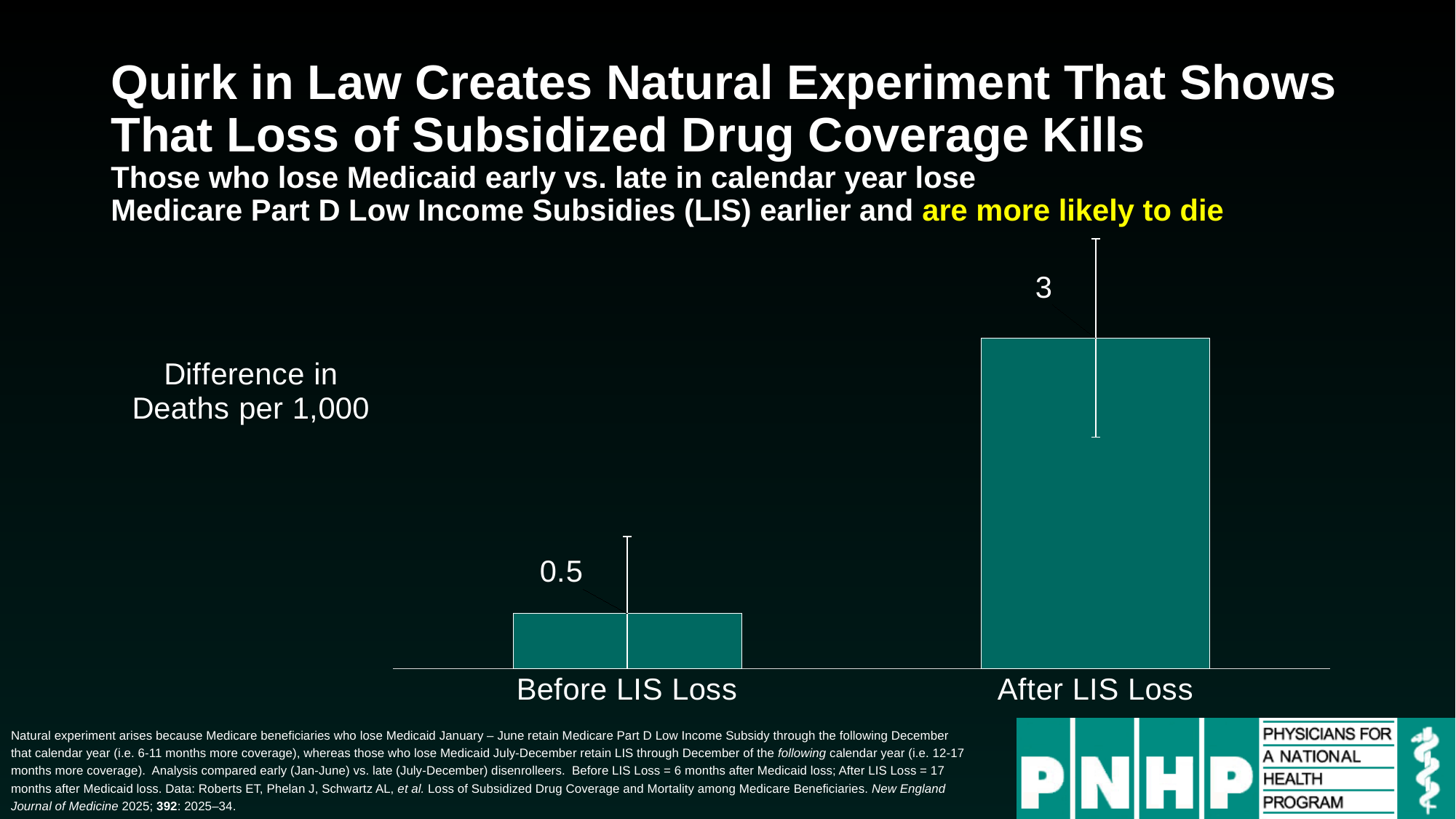
What colour are the bars in the chart? teal Do the values rise or fall from Before LIS Loss to After LIS Loss? rise What kind of chart is shown on the slide? bar chart Which category has the higher value, Before LIS Loss or After LIS Loss? After LIS Loss What is the difference in deaths per 1,000 for After LIS Loss? 3 What is the difference in deaths per 1,000 for Before LIS Loss? 0.5 How many categories are shown on the chart? 2 Which category has the lowest value? Before LIS Loss How much larger is the value for After LIS Loss than for Before LIS Loss? 2.5 What quantity does the chart's axis label say is plotted? Difference in Deaths per 1,000 Is the value for Before LIS Loss larger or smaller than the value for After LIS Loss? smaller